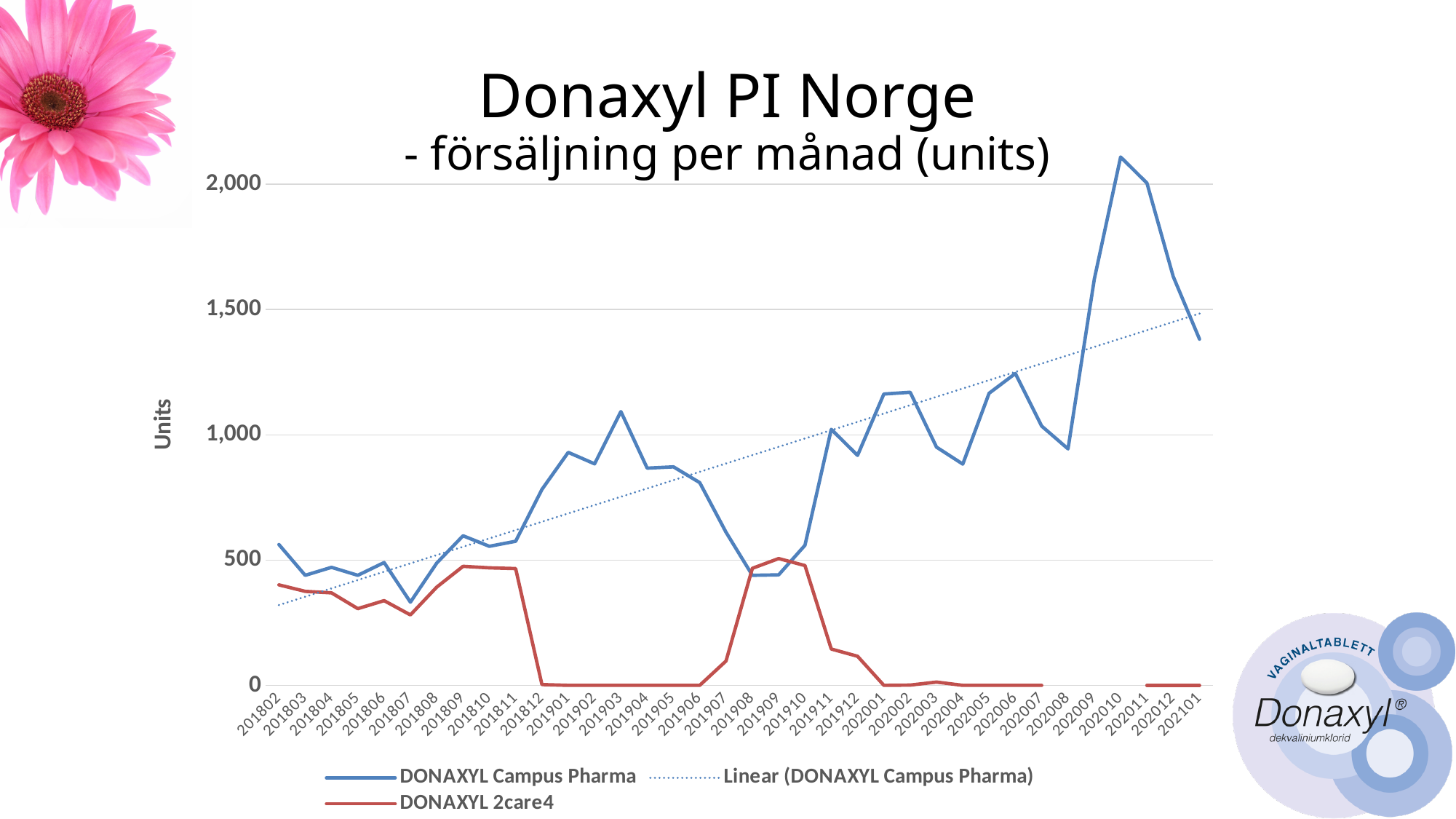
What kind of chart is shown on the slide? Line chart Is the value for DONAXYL Campus Pharma in 202101 greater or less than 1,500? less In which month does the DONAXYL Campus Pharma series reach its lowest value? 201807 How many months (x-axis categories) are plotted on the chart? 36 What is the label on the vertical axis of the chart? Units Does the DONAXYL Campus Pharma series rise or fall from 202010 to 202101? Fall Is the value for DONAXYL Campus Pharma in 201903 greater or less than 1,000? greater Is the value for DONAXYL Campus Pharma in 202010 greater or less than 2,000? greater In 201811, which series has the higher value: DONAXYL Campus Pharma or DONAXYL 2care4? DONAXYL Campus Pharma How many entries does the chart legend list? 3 In which month does the DONAXYL Campus Pharma series reach its highest value? 202010